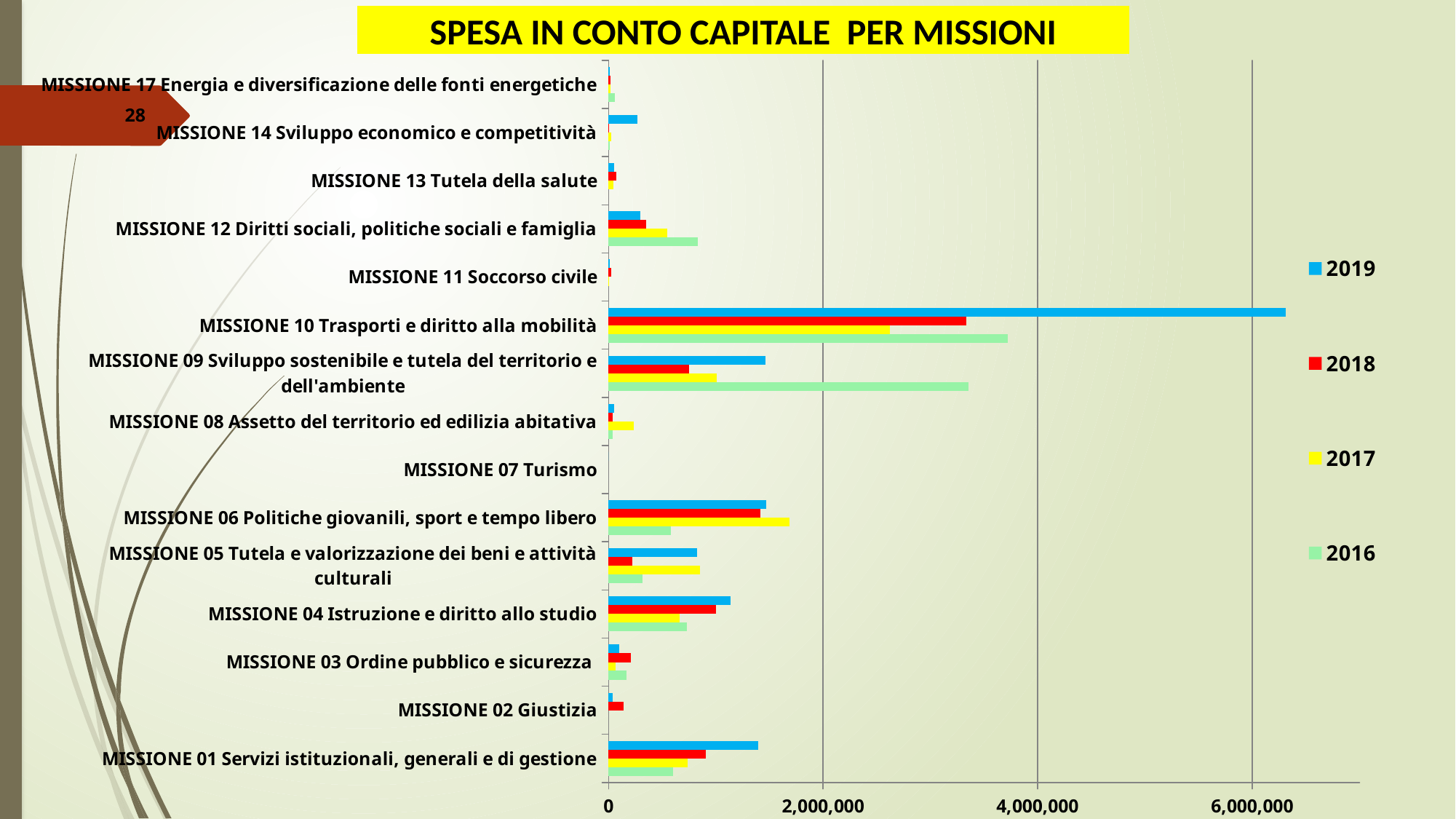
For MISSIONE 06 Politiche giovanili, sport e tempo libero, which year has the larger value: 2017 or 2016? 2017 Is the 2016 value for MISSIONE 09 Sviluppo sostenibile e tutela del territorio e dell'ambiente greater or less than 2,000,000? greater What is the title of the chart? SPESA IN CONTO CAPITALE PER MISSIONI How many series does the legend list? 4 What colour represents the 2019 series in the legend? blue For MISSIONE 09 Sviluppo sostenibile e tutela del territorio e dell'ambiente, which year has the larger value: 2016 or 2018? 2016 What kind of chart is shown on the slide? bar chart For MISSIONE 10 Trasporti e diritto alla mobilità, which year has the larger value: 2019 or 2016? 2019 Is the 2019 value for MISSIONE 10 Trasporti e diritto alla mobilità greater or less than 6,000,000? greater How many missions (categories) are shown on the chart? 15 Is the 2019 value for MISSIONE 01 Servizi istituzionali, generali e di gestione greater or less than 2,000,000? less Which mission has the highest value for 2019? MISSIONE 10 Trasporti e diritto alla mobilità